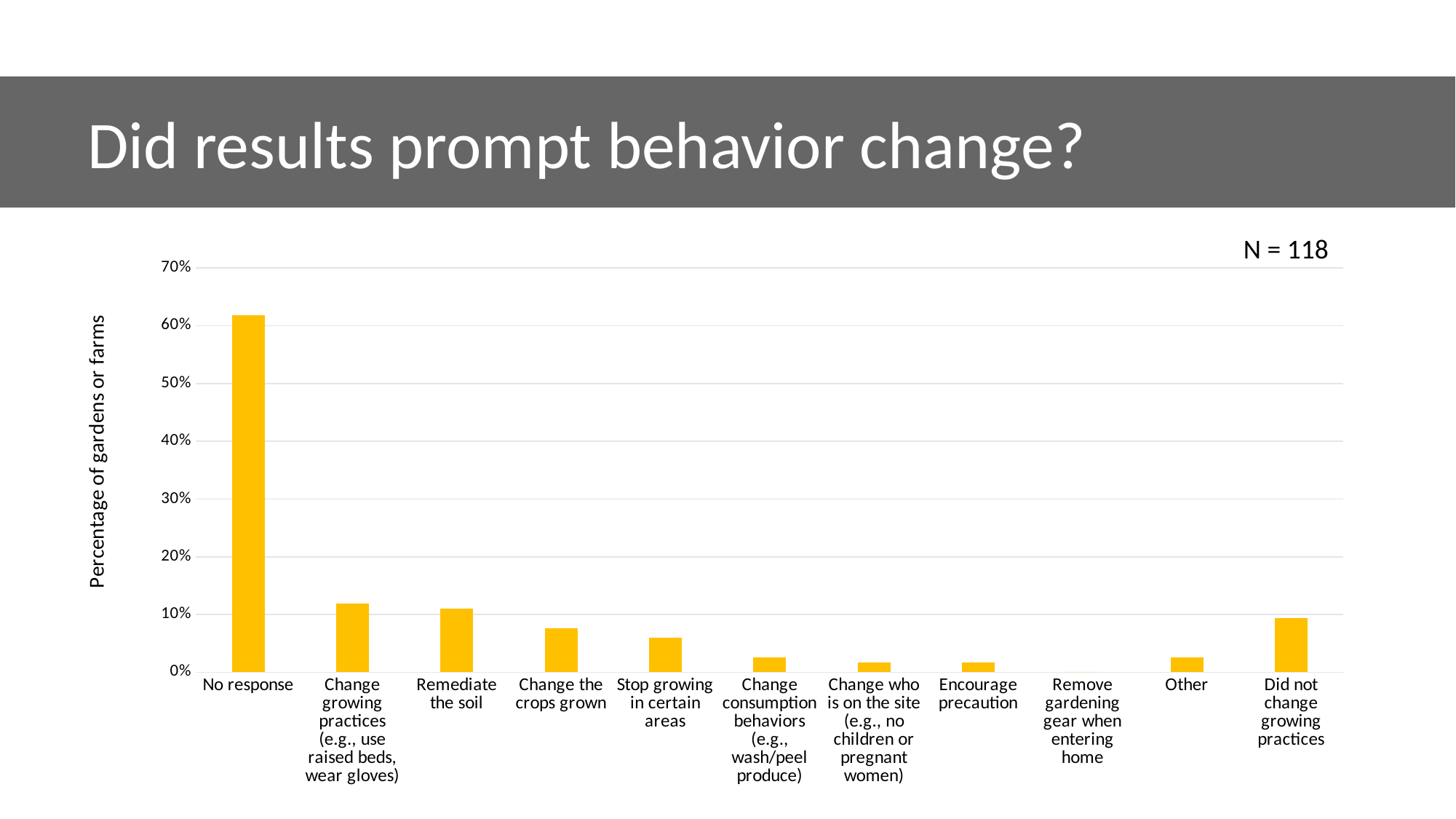
Is the value for No response greater or less than 50%? greater Which is larger, the value for Change the crops grown or the value for Stop growing in certain areas? Change the crops grown Is the value for Change the crops grown greater or less than 10%? less How many categories are shown on the x axis? 11 Which is larger, the value for Did not change growing practices or the value for Change consumption behaviors (e.g., wash/peel produce)? Did not change growing practices What sample size (N) is shown on the chart? N = 118 Which category has the highest percentage of gardens or farms? No response Which category has the lowest percentage of gardens or farms? Remove gardening gear when entering home What kind of chart is shown on the slide? Bar chart Is the value for Change growing practices (e.g., use raised beds, wear gloves) greater or less than 10%? greater What is the title of the y axis? Percentage of gardens or farms